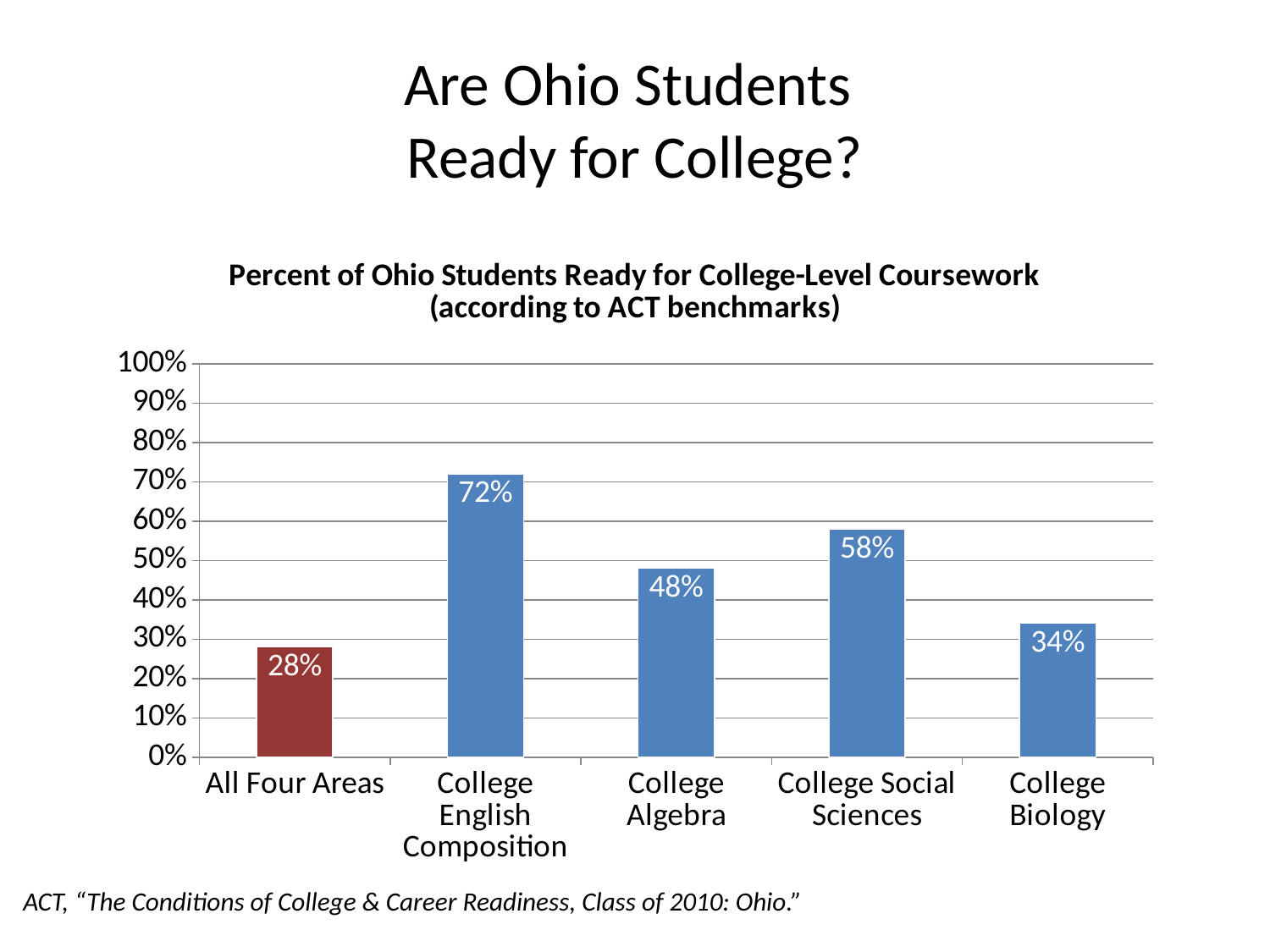
Which is larger, College Algebra or College Social Sciences? College Social Sciences What percent of Ohio students are ready for College Biology? 34% What is the difference between College Social Sciences and College Biology? 24% What kind of chart is shown? bar chart Is the value for College Algebra greater or less than 50%? less What percent of Ohio students are ready for College English Composition? 72% Which category has the highest value? College English Composition What is the difference between College English Composition and College Algebra? 24% What is the value for All Four Areas? 28% Which category has the lowest value? All Four Areas How many categories are shown on the x axis? 5 Which bar is coloured differently (red) from the others? All Four Areas